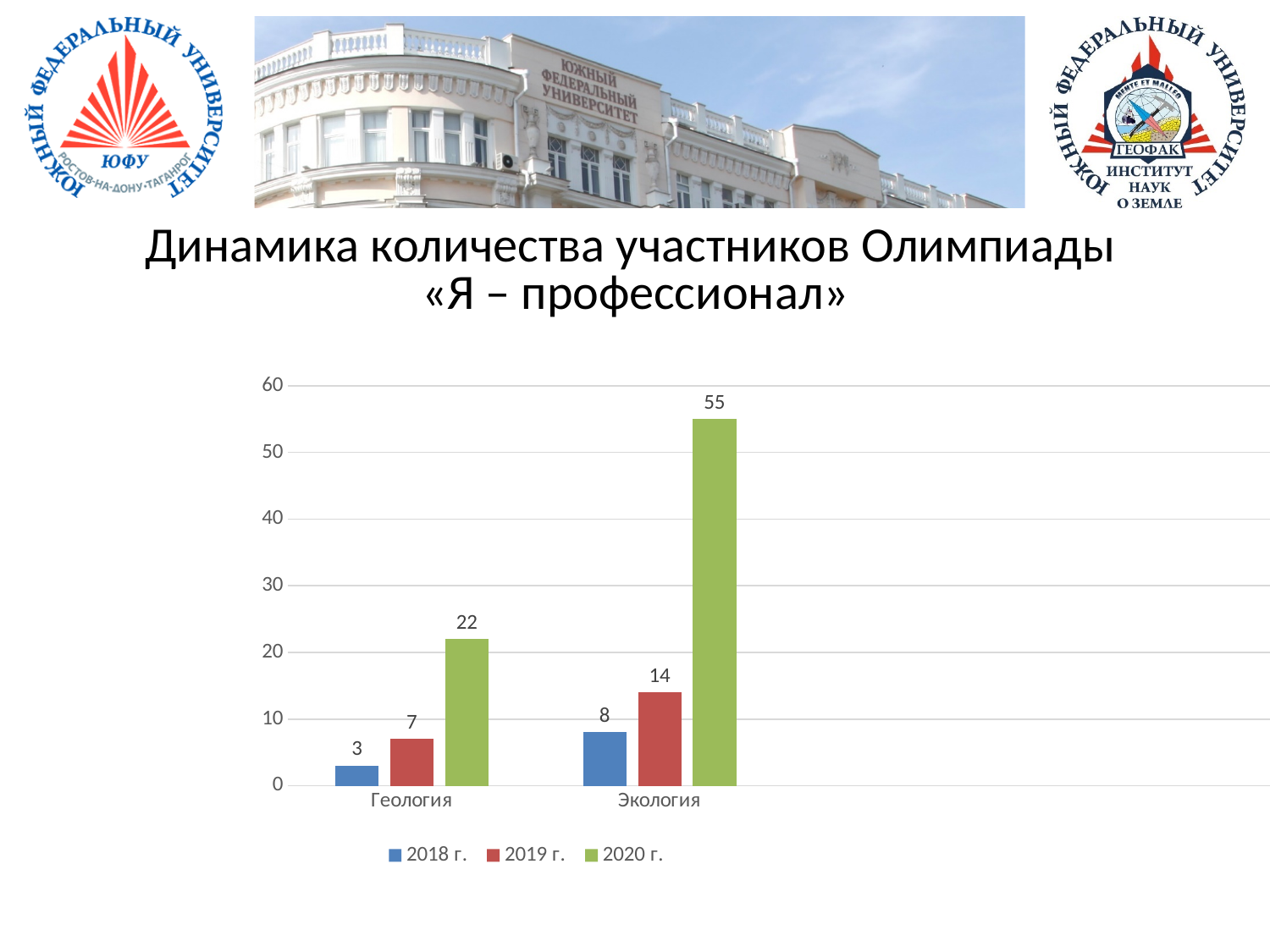
What is the value for Геология in 2018 г.? 3 Which is larger: the 2019 г. value for Экология or the 2020 г. value for Геология? 2020 г. value for Геология What is the value for Геология in 2019 г.? 7 What kind of chart is shown on the slide? Bar chart How many series does the legend list? 3 Which category has the lowest value in 2018 г.? Геология What is the difference between the 2020 г. values for Экология and Геология? 33 Which category has the highest value in 2020 г.? Экология How many categories are shown on the x axis? 2 What is the value for Экология in 2020 г.? 55 Which series is shown in green in the legend? 2020 г. What is the value for Экология in 2019 г.? 14